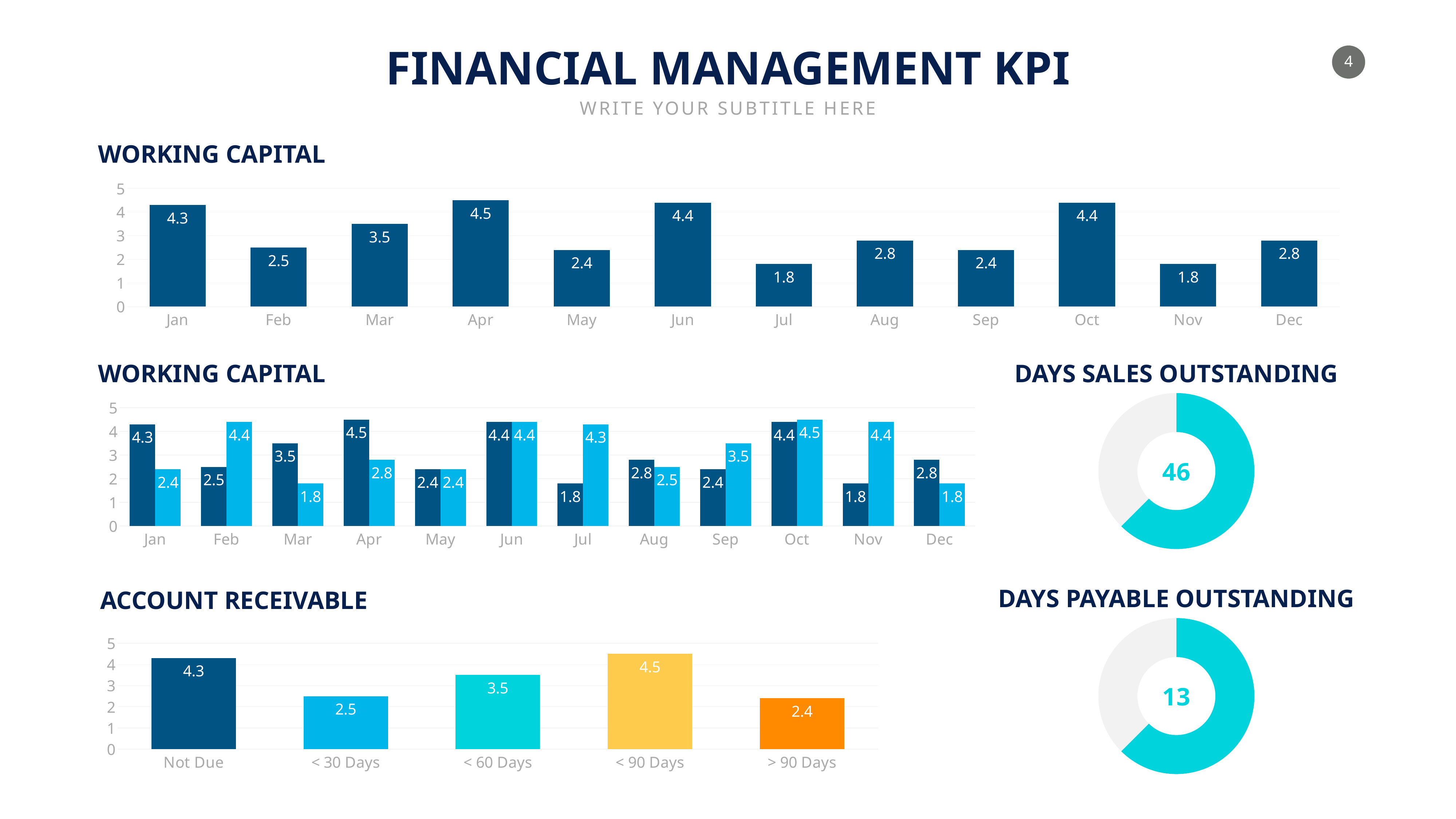
In the top Working Capital chart, what is the difference between the values for Jan and Feb? 1.8 In the top Working Capital chart, what is the value for Apr? 4.5 In the top Working Capital chart, is the value for Mar greater or less than 3? greater In the Account Receivable chart, what is the value for < 60 Days? 3.5 In the top Working Capital chart, how many months are plotted? 12 In the Account Receivable chart, what is the difference between Not Due and < 30 Days? 1.8 In the middle-left Working Capital chart, for Jul, which bar is larger, the dark blue or the light blue? light blue In the Account Receivable chart, which category has the highest value? < 90 Days In the Account Receivable chart, which category has the lowest value? > 90 Days What value is shown in the centre of the Days Sales Outstanding chart? 46 In the middle-left Working Capital chart, what is the value of the light blue bar for Feb? 4.4 In the top Working Capital chart, which month has the highest value? Apr